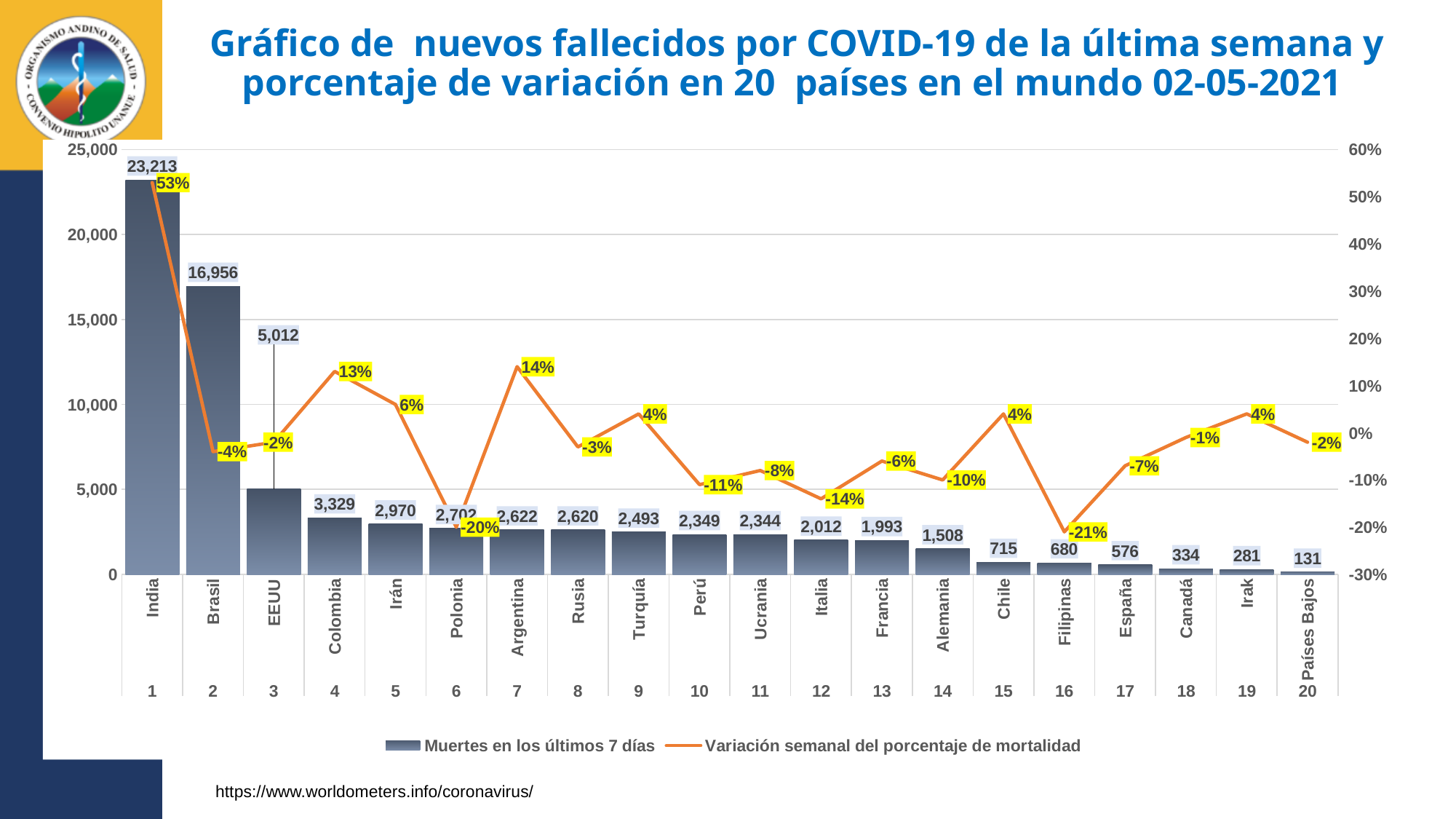
What kind of chart is used for the 'Muertes en los últimos 7 días' series? Bar chart How many countries are shown on the chart? 20 Which has more deaths in the last 7 days, Chile or Filipinas? Chile Which country has the lowest weekly variation percentage on the line? Filipinas Which country has the lowest number of deaths in the last 7 days? Países Bajos What is the weekly variation percentage shown for Polonia? -20% What is the difference in deaths in the last 7 days between India and Brasil? 6,257 Do the bar values for deaths in the last 7 days rise or fall from left to right across the countries? Fall What is the weekly variation percentage shown for Colombia? 13% How many deaths in the last 7 days does the chart show for India? 23,213 How many series does the legend list? 2 Which country has the highest weekly variation percentage on the line? India